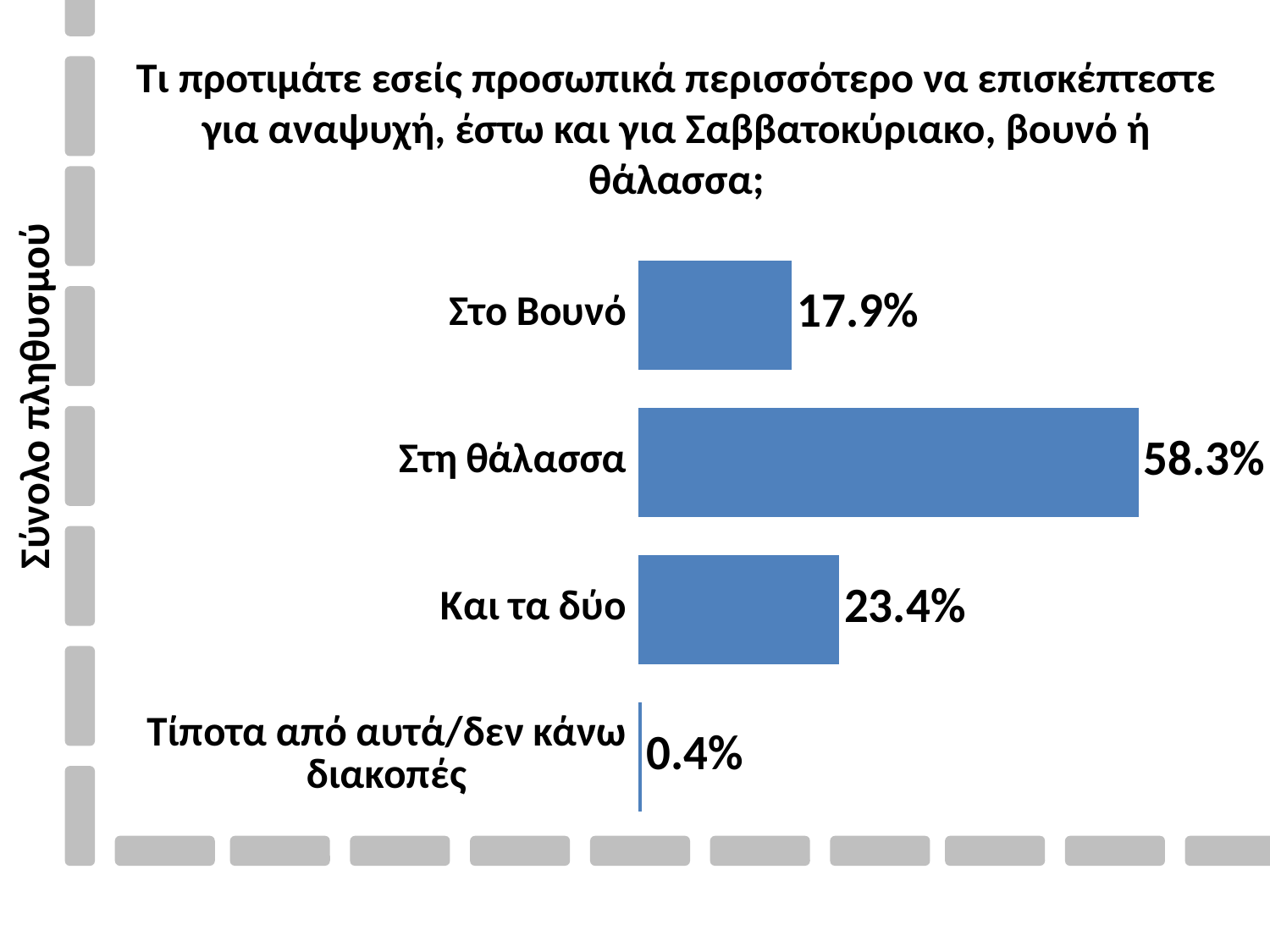
What is the value for Στο Βουνό? 17.9% What is the value for Τίποτα από αυτά/δεν κάνω διακοπές? 0.4% Which category has the lowest value? Τίποτα από αυτά/δεν κάνω διακοπές What is the difference between the values for Και τα δύο and Στο Βουνό? 5.5% How many categories are shown in the chart? 4 What is the value for Και τα δύο? 23.4% What is the label on the vertical axis of the chart? Σύνολο πληθυσμού Which category has the highest value? Στη θάλασσα What kind of chart is shown on the slide? Bar chart Which is larger, the value for Στο Βουνό or the value for Και τα δύο? Και τα δύο What is the difference between the values for Στη θάλασσα and Και τα δύο? 34.9% What is the value for Στη θάλασσα? 58.3%